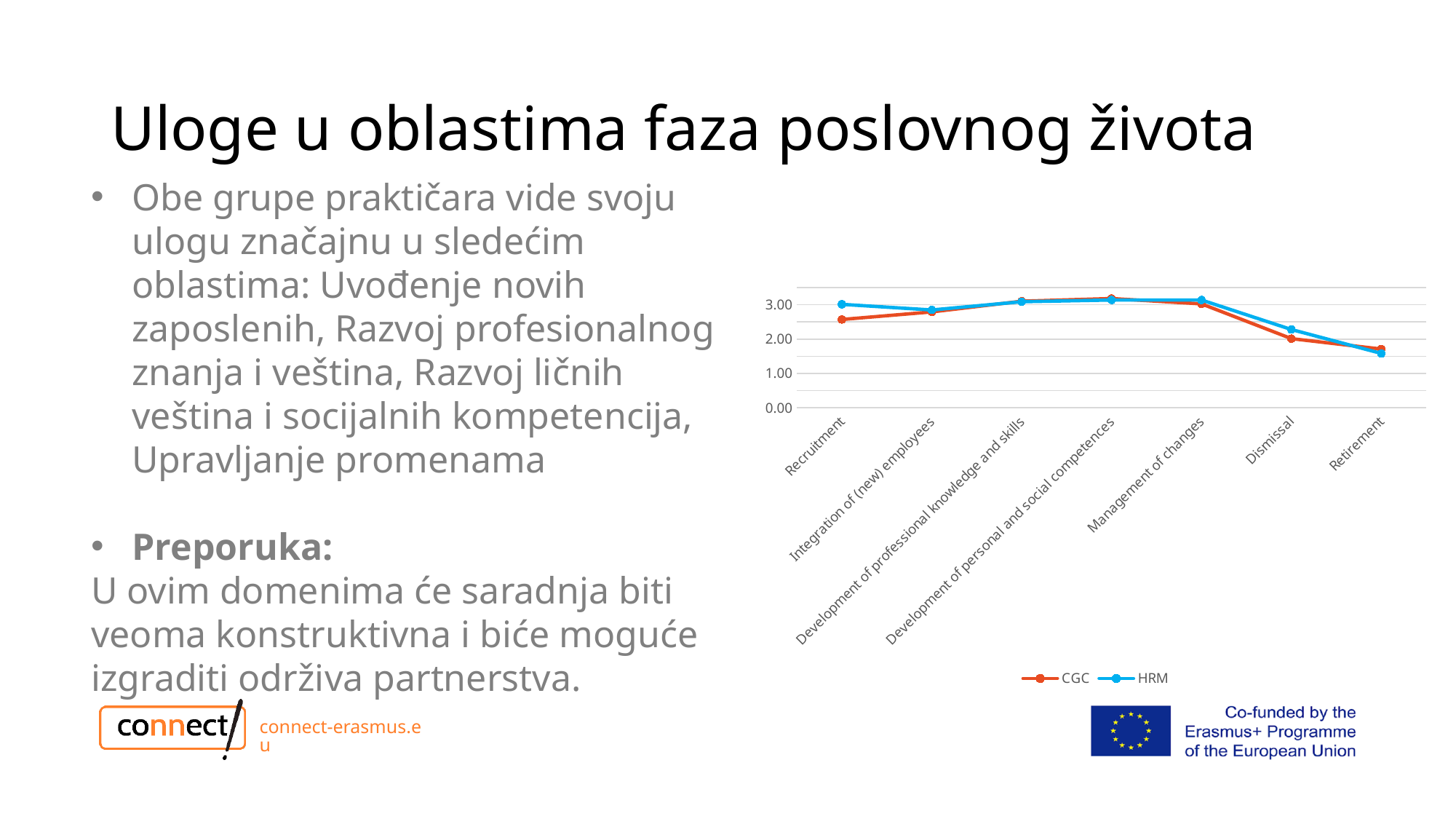
Is the CGC value for Recruitment greater or less than 3.00? less Which two series are listed in the chart's legend? CGC and HRM Is the CGC value for Development of personal and social competences greater or less than 3.00? greater Which category has the lowest HRM value? Retirement How many categories are plotted along the x axis of the chart? 7 At Recruitment, which series has the higher value, CGC or HRM? HRM What kind of chart is shown on the slide? line chart Is the HRM value for Dismissal greater or less than 2.00? greater How many series does the chart's legend list? 2 Which category has the lowest CGC value? Retirement